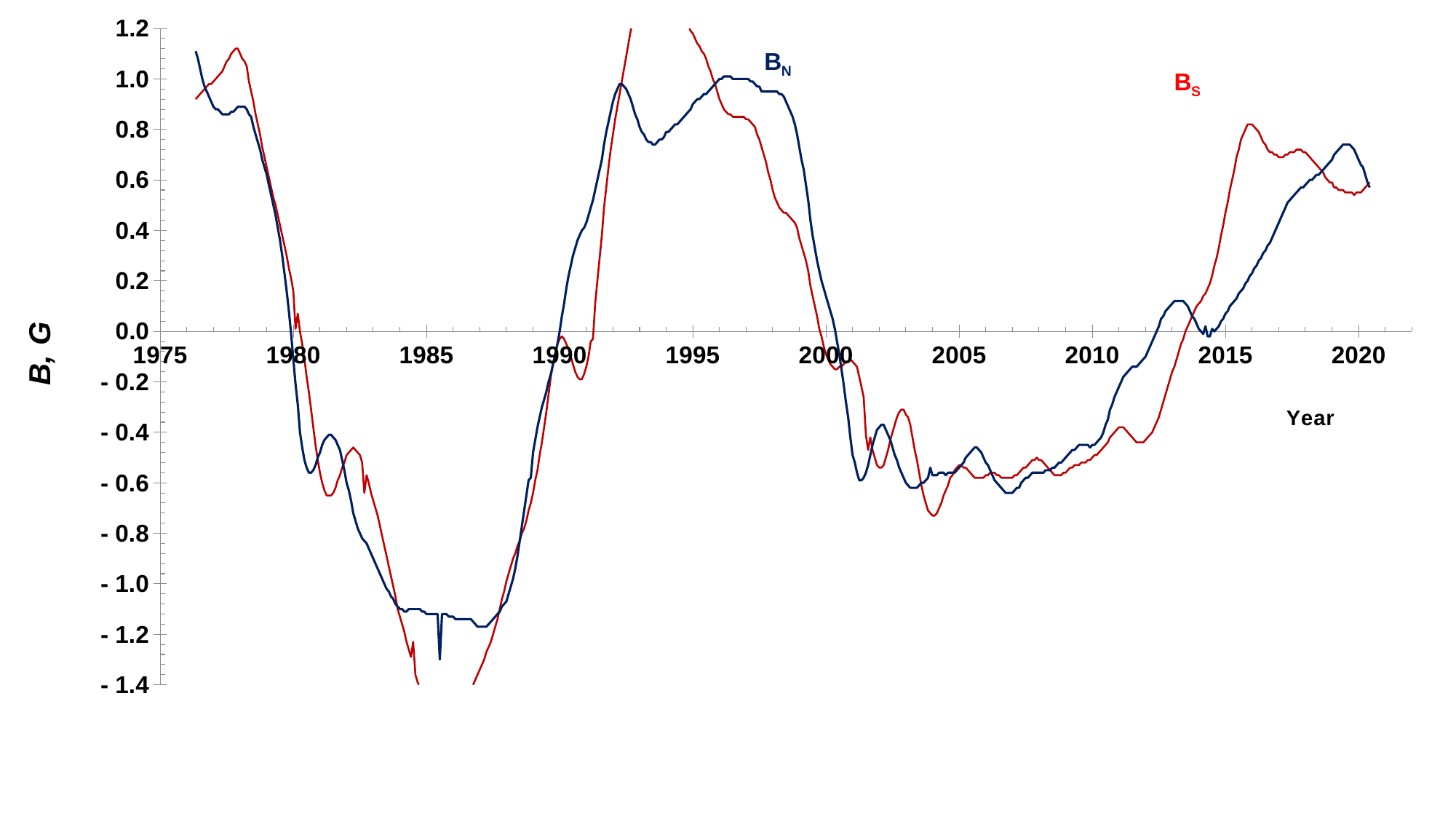
Does B_N rise or fall between 1990 and 1992? rise How many data series are plotted on the chart? 2 What colour is the B_S line? red Is the value of B_N around 2007 greater or less than -0.4? less Is the value of B_S around 1985 greater or less than -1.2? less Is the value of B_N around 1985 greater or less than -1.0? less Around 2016, which series has the larger value, B_N or B_S? B_S What kind of chart is shown on the slide? line chart Does B_S rise or fall between 1997 and 2000? fall What is the label of the vertical axis? B, G